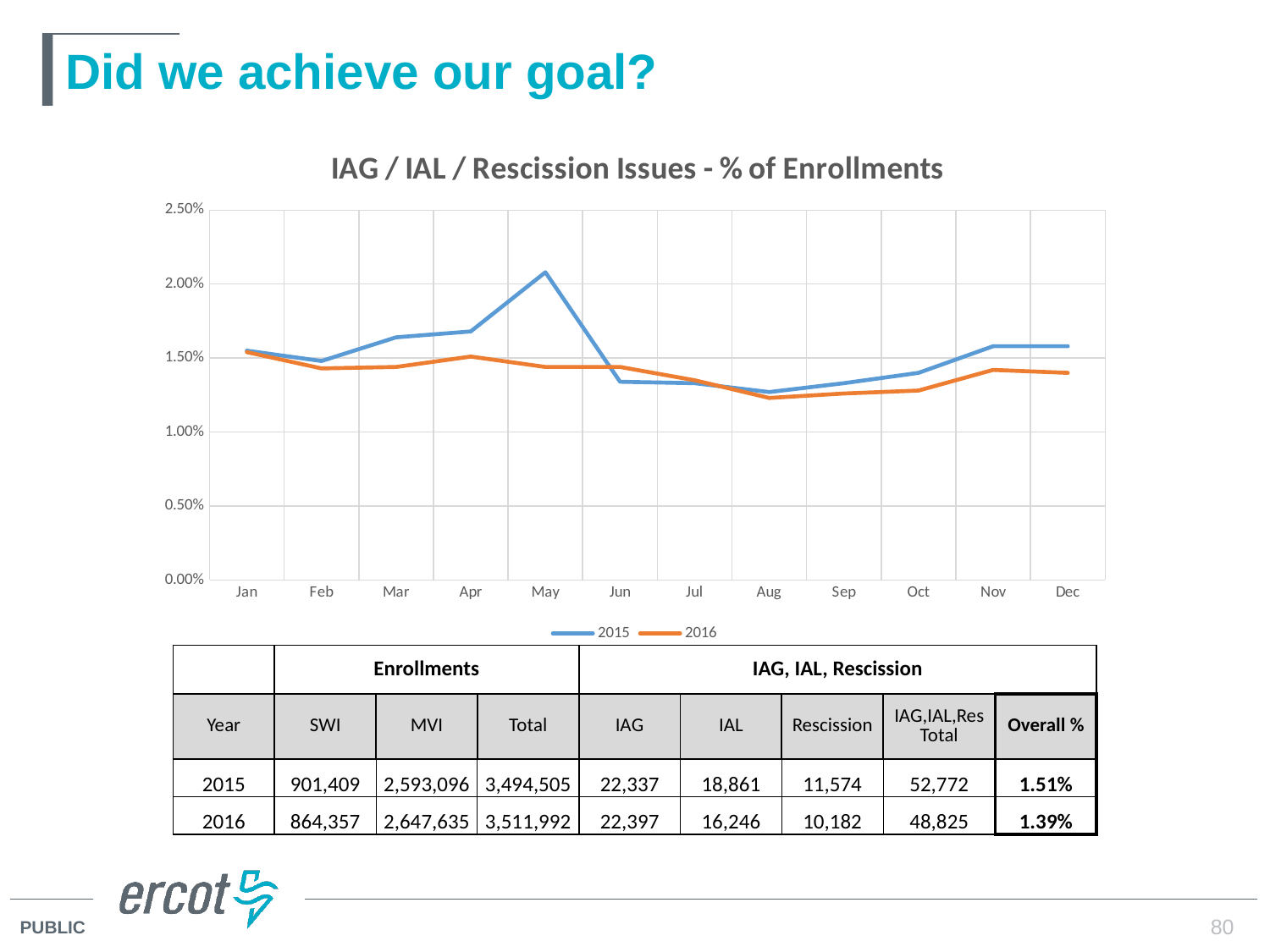
Is the 2015 value for Aug greater or less than 1.50%? less Which series has the higher value in May, 2015 or 2016? 2015 How many series does the chart legend list? 2 Does the 2015 series rise or fall from May to Aug? fall Is the 2015 value for May greater or less than 2.00%? greater Is the 2015 value for Mar greater or less than 1.50%? greater What kind of chart is shown on the slide? line chart In which month does the 2015 series reach its highest value? May How many months are plotted along the x axis of the chart? 12 In which month does the 2015 series reach its lowest value? Aug What is the title of the chart? IAG / IAL / Rescission Issues - % of Enrollments